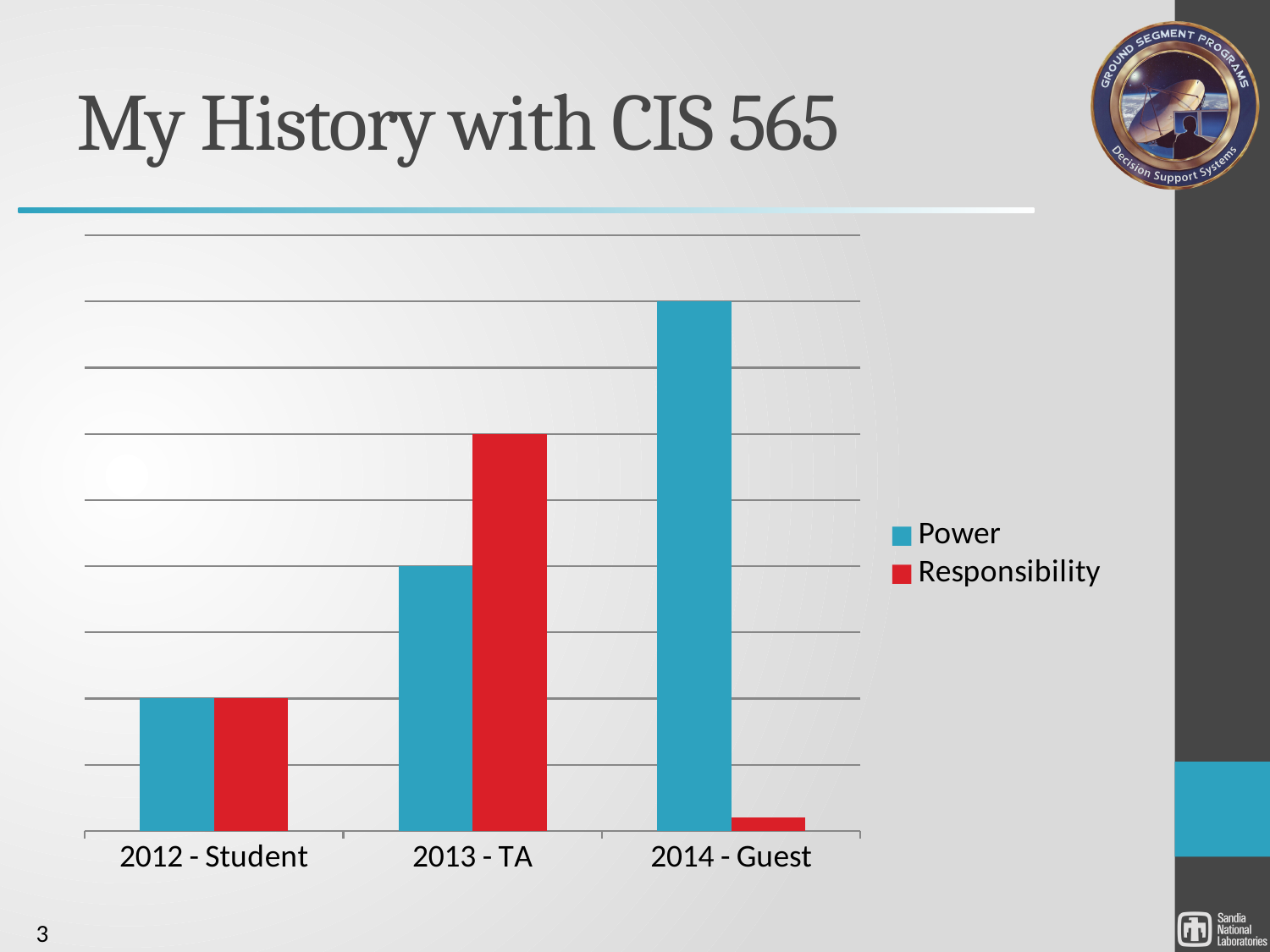
Which category has the lowest Responsibility value? 2014 - Guest Does the Power series rise or fall from 2012 - Student to 2014 - Guest? Rise What are the two series named in the chart's legend? Power and Responsibility How many categories are shown on the x axis of the chart? 3 Which category has the highest Responsibility value? 2013 - TA For 2013 - TA, which is larger: Power or Responsibility? Responsibility Which category has the lowest Power value? 2012 - Student What kind of chart is shown on the slide? Bar chart Which category has the highest Power value? 2014 - Guest What colour represents the Responsibility series in the chart? Red For 2014 - Guest, which is larger: Power or Responsibility? Power How many series does the chart's legend list? 2